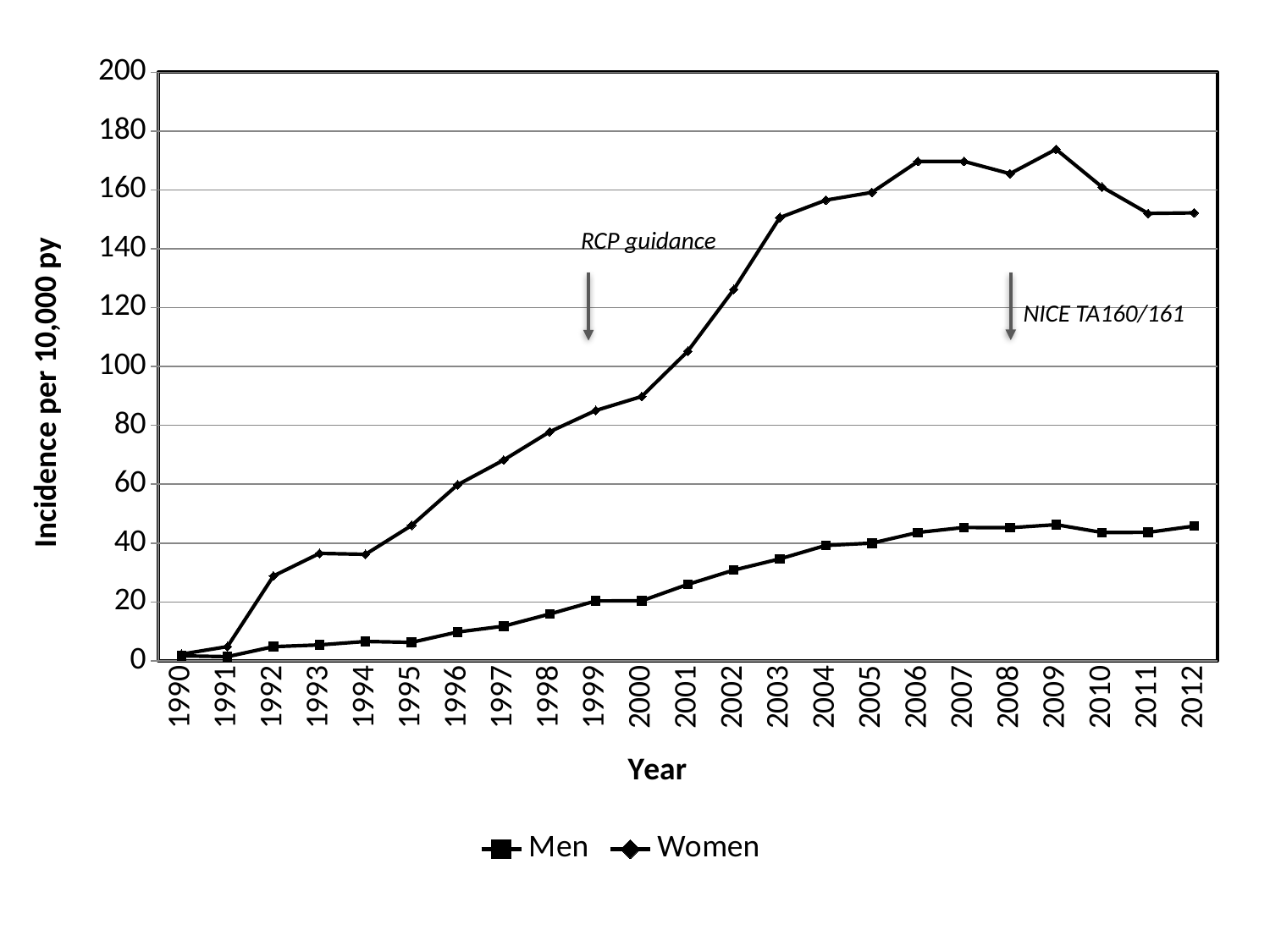
How many years are plotted along the x axis? 23 Which two series are listed in the legend? Men and Women Is the value for Women in 2003 greater or less than 140? greater Does the Women series rise or fall between 2009 and 2011? fall What kind of chart is shown on the slide? line chart Is the value for Women in 1999 greater or less than 100? less Is the value for Men in 1995 greater or less than 20? less Does the Men series generally rise or fall from 1990 to 2012? rise What is the title of the y axis? Incidence per 10,000 py Which series has the higher value in 2005, Men or Women? Women How many series does the legend list? 2